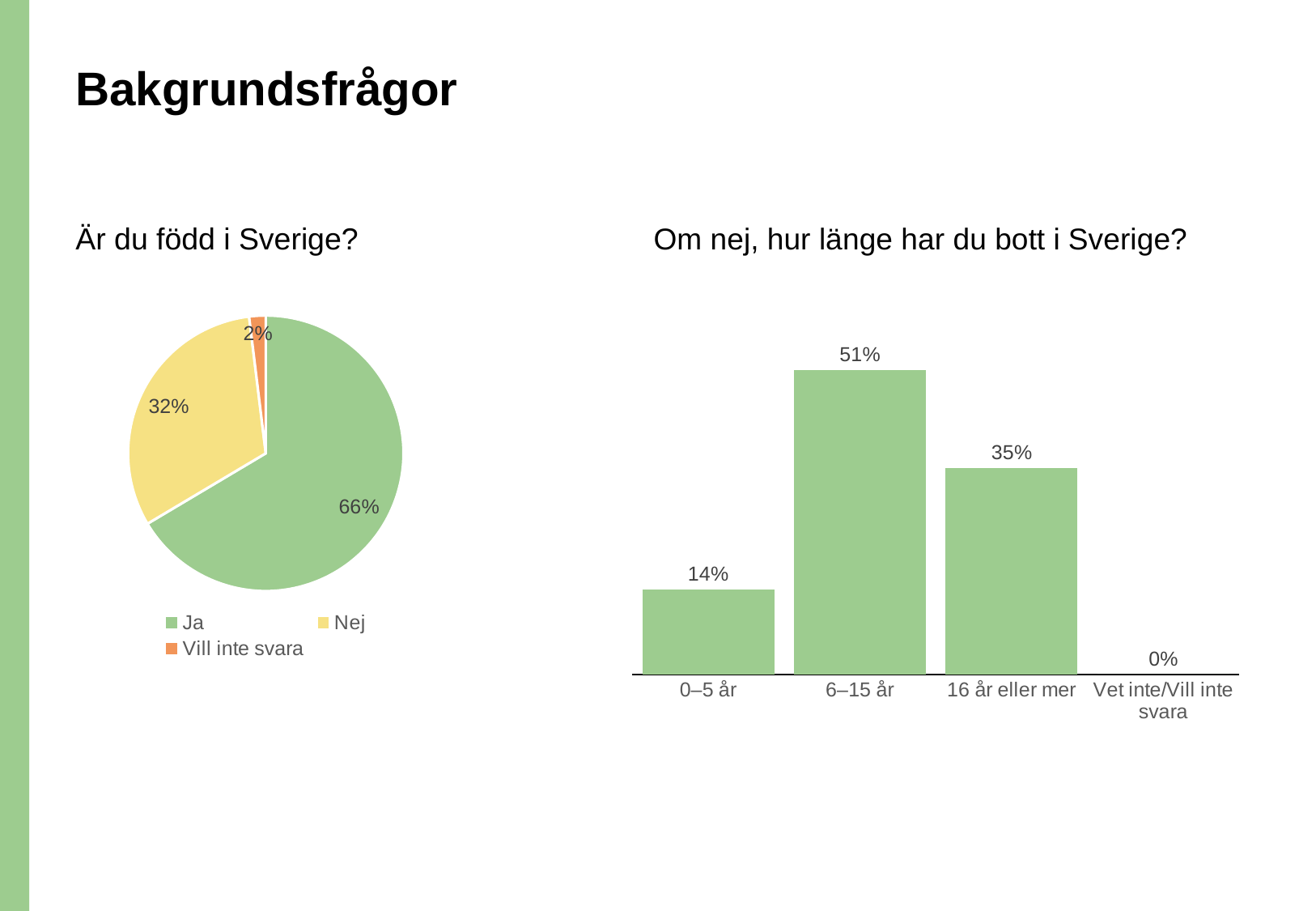
What kind of chart is 'Om nej, hur länge har du bott i Sverige?'? Bar chart In the chart 'Om nej, hur länge har du bott i Sverige?', what is the value for '0–5 år'? 14% In the pie chart 'Är du född i Sverige?', what is the value for 'Vill inte svara'? 2% In the chart 'Om nej, hur länge har du bott i Sverige?', what is the value for '6–15 år'? 51% In the pie chart 'Är du född i Sverige?', how many categories does the legend list? 3 In the pie chart 'Är du född i Sverige?', what share of respondents answered 'Ja'? 66% In the pie chart 'Är du född i Sverige?', what share of respondents answered 'Nej'? 32% In the chart 'Om nej, hur länge har du bott i Sverige?', which category has the lowest value? Vet inte/Vill inte svara In the chart 'Om nej, hur länge har du bott i Sverige?', which is larger: '0–5 år' or '16 år eller mer'? 16 år eller mer In the chart 'Om nej, hur länge har du bott i Sverige?', what is the difference between '6–15 år' and '16 år eller mer'? 16% In the chart 'Om nej, hur länge har du bott i Sverige?', which category has the highest value? 6–15 år In the pie chart 'Är du född i Sverige?', which category has the largest slice? Ja